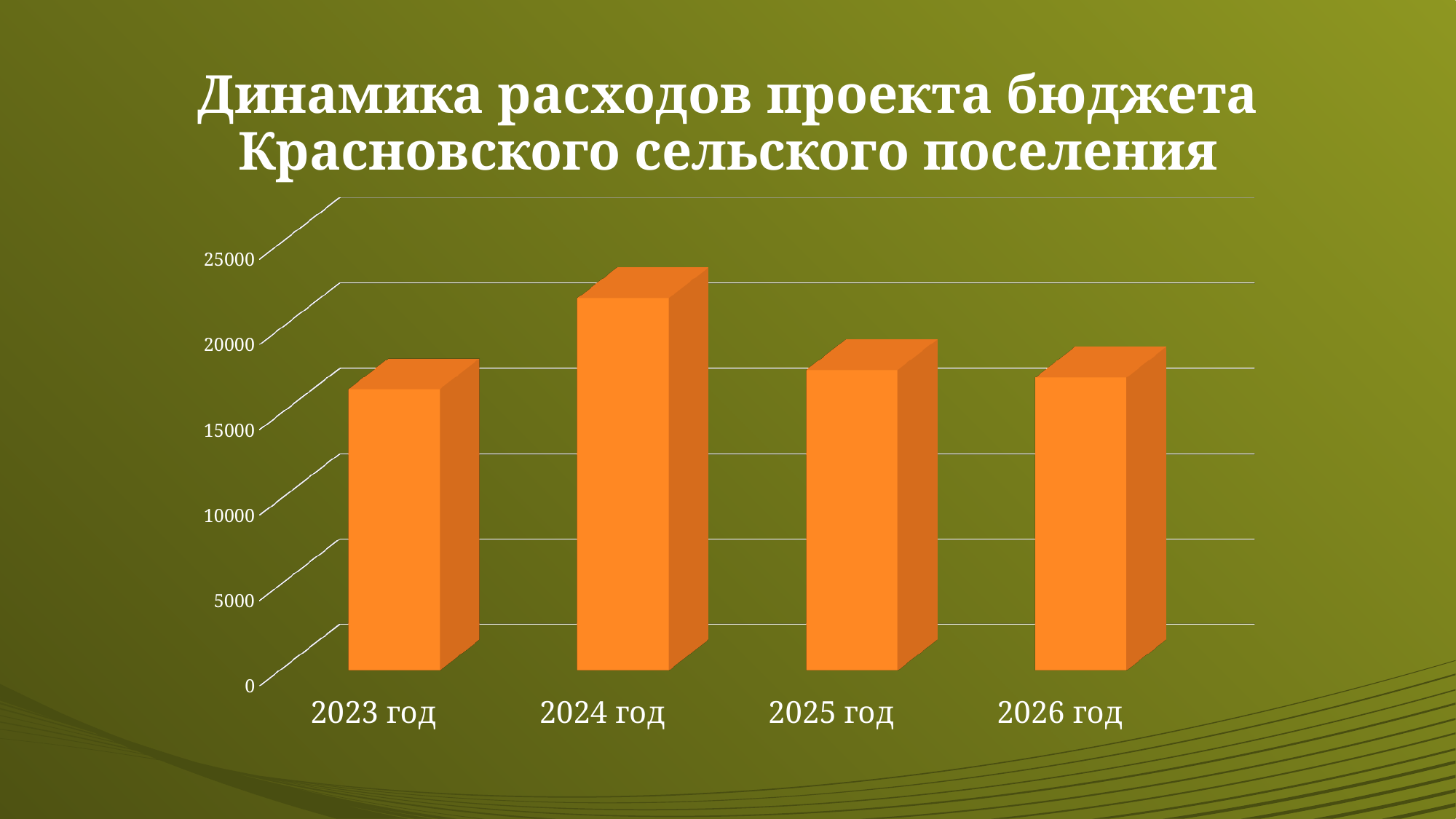
What kind of chart is shown on the slide? bar chart Does the value rise or fall from 2024 год to 2025 год? fall Is the value for 2023 год greater or less than 20000? less Is the value for 2023 год greater or less than 15000? greater What is the title of the chart on the slide? Динамика расходов проекта бюджета Красновского сельского поселения Is the value for 2024 год greater or less than 20000? greater Does the value rise or fall from 2023 год to 2024 год? rise How many years (categories) are plotted on the chart? 4 Which year has the highest value on the chart? 2024 год Which is larger, the value for 2024 год or the value for 2025 год? 2024 год